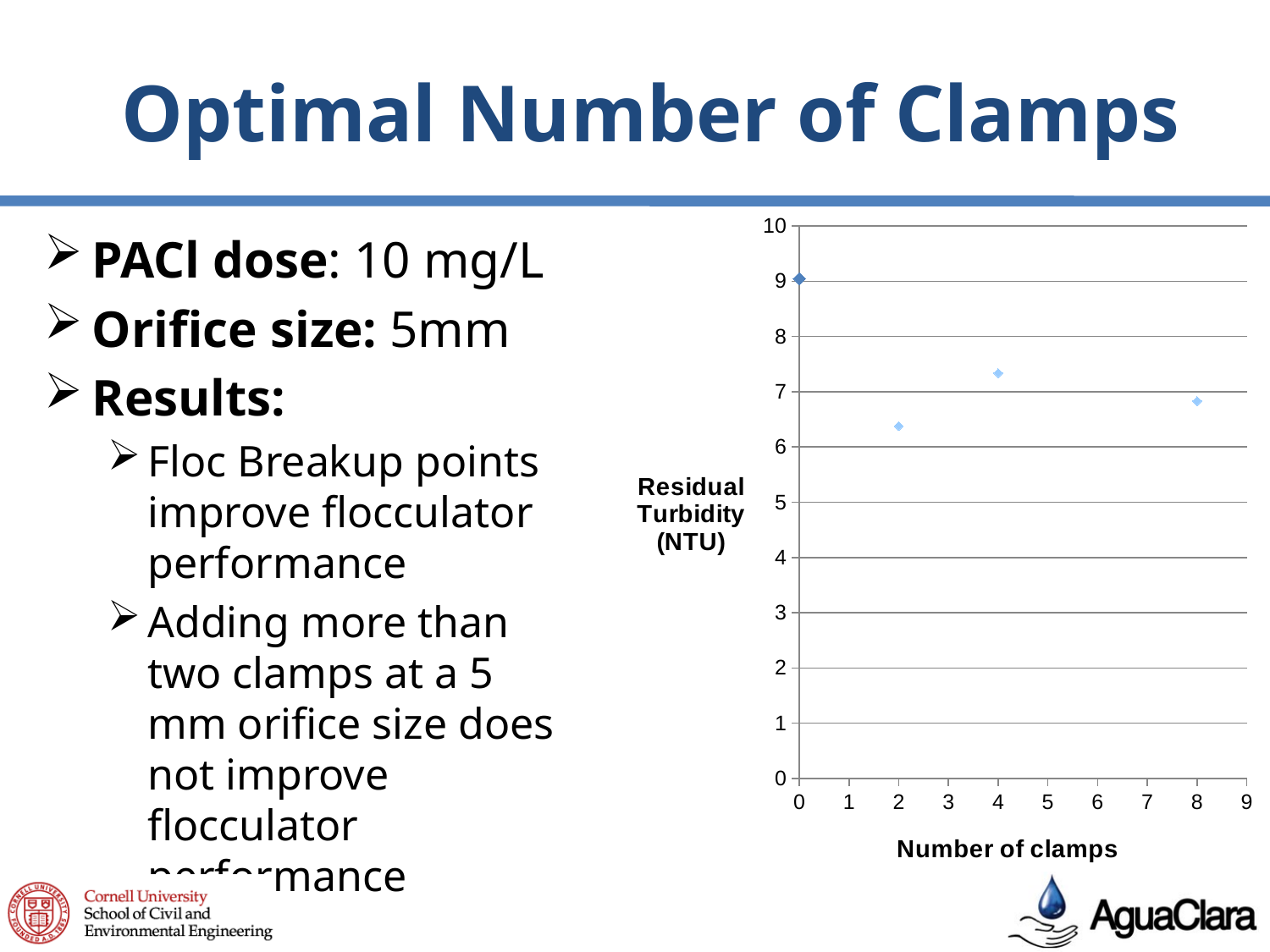
What is the label of the x axis? Number of clamps What is the label of the y axis? Residual Turbidity (NTU) How many data points are plotted on the chart? 4 Is the residual turbidity at 4 clamps greater or less than 7? greater What kind of chart is shown on the slide? scatter plot Is the residual turbidity at 0 clamps greater or less than 8? greater Is the residual turbidity at 2 clamps greater or less than 7? less Which has the higher residual turbidity, 4 clamps or 2 clamps? 4 clamps At which number of clamps is the residual turbidity highest? 0 At which number of clamps is the residual turbidity lowest? 2 Which has the higher residual turbidity, 4 clamps or 8 clamps? 4 clamps